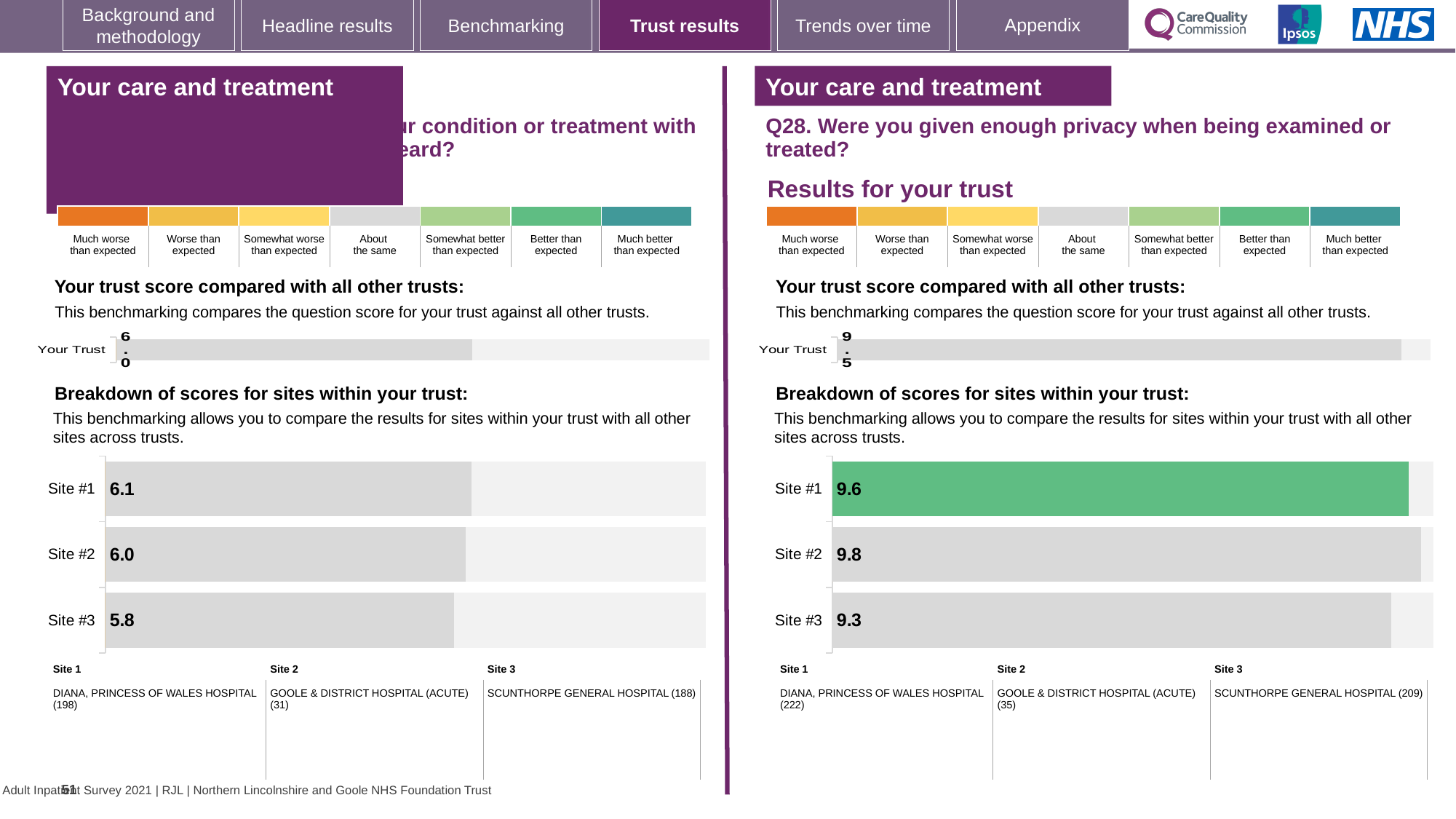
On the left-hand site breakdown chart, what is the difference between the scores for Site #1 and Site #3? 0.3 On the left-hand site breakdown chart, what is the score for Site #1? 6.1 On the Q28 site breakdown chart (right-hand side), what is the score for Site #2? 9.8 On the Q28 site breakdown chart (right-hand side), which has the higher score, Site #1 or Site #3? Site #1 What type of chart is used for the site breakdown on the left-hand side of the slide? Bar chart On the Q28 site breakdown chart (right-hand side), what is the score for Site #3? 9.3 On the Q28 'Your trust score compared with all other trusts' chart (right-hand side), what is the score for Your Trust? 9.5 On the Q28 site breakdown chart (right-hand side), which site has the highest score? Site #2 On the Q28 site breakdown chart (right-hand side), what is the difference between the scores for Site #2 and Site #3? 0.5 On the left-hand 'Your trust score compared with all other trusts' chart, what is the score for Your Trust? 6.0 How many sites are shown on the Q28 site breakdown chart (right-hand side)? 3 On the left-hand site breakdown chart, which site has the lowest score? Site #3